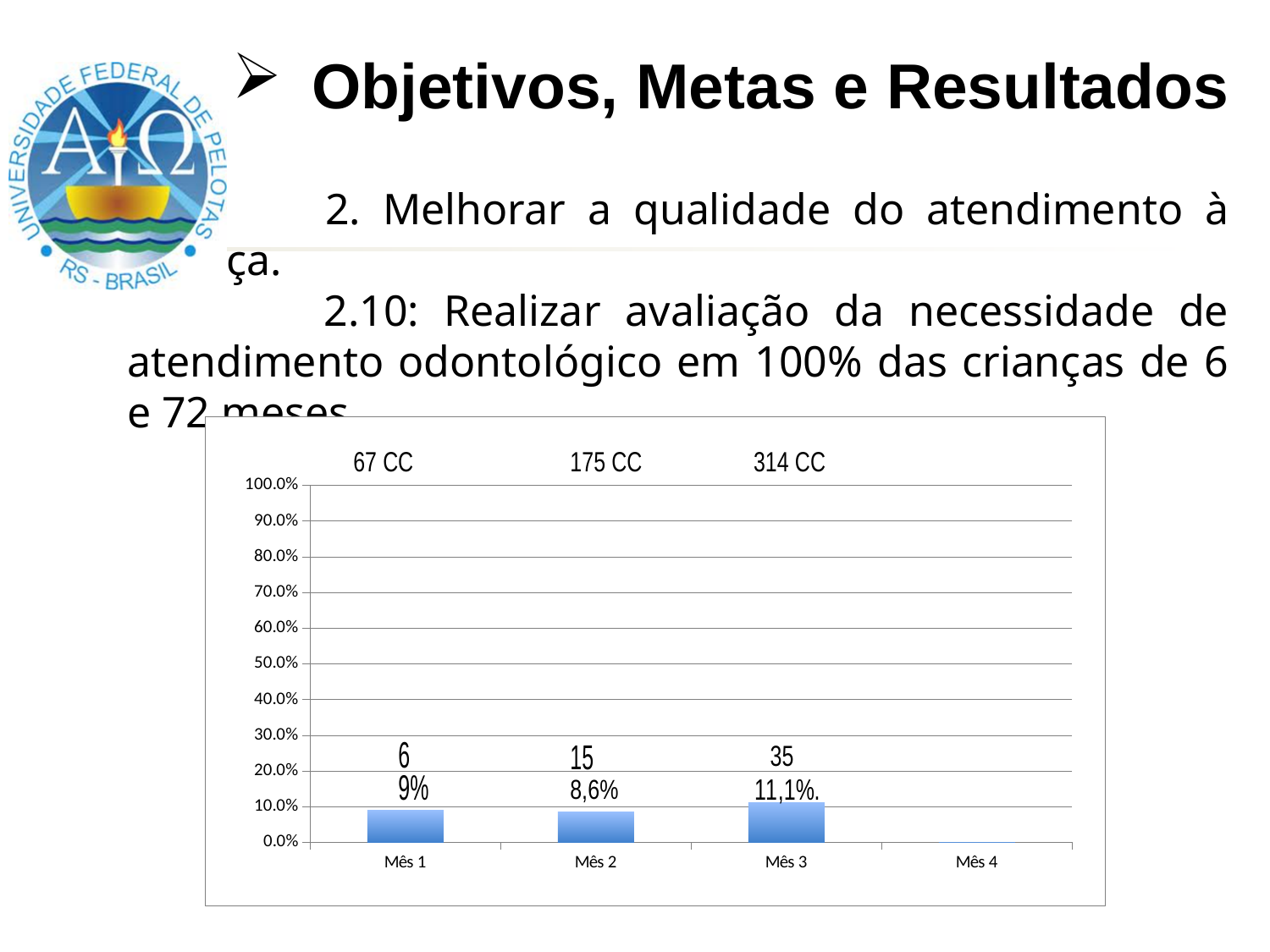
Is the value for Mês 3 greater or less than 20%? less What percentage is labelled for Mês 1? 9% What kind of chart is shown on the slide? bar chart What is the difference between the percentages for Mês 3 and Mês 2? 2,5% What number of CC is written above Mês 3? 314 CC Which month has the highest bar? Mês 3 How many months have a bar plotted? 3 What percentage is labelled for Mês 2? 8,6% How many categories are shown on the x axis? 4 Is the value for Mês 1 greater or less than Mês 2? greater Which of the months with a bar has the lowest value? Mês 2 What percentage is labelled for Mês 3? 11,1%